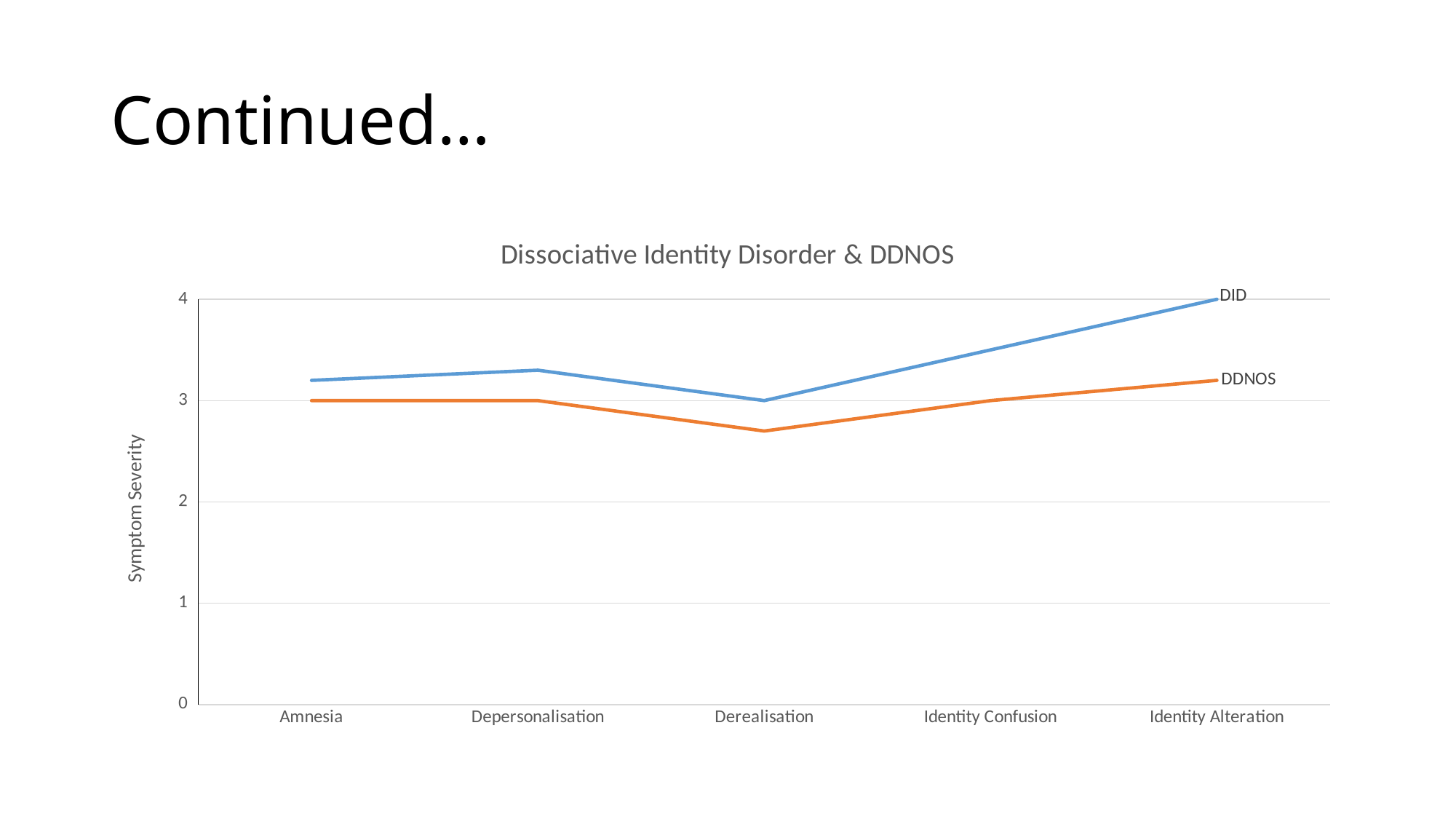
What is the title of the chart? Dissociative Identity Disorder & DDNOS How many symptom categories are shown along the x axis? 5 What is the DID value for Identity Alteration? 4 What kind of chart is shown on the slide? line chart For which category is the DID series highest? Identity Alteration What is the DDNOS value for Amnesia? 3 For which category is the DDNOS series lowest? Derealisation What is the label on the vertical axis of the chart? Symptom Severity Is the DDNOS value for Derealisation greater or less than 3? less Which series has the larger value for Identity Alteration, DID or DDNOS? DID How many series are plotted in the chart? 2 Does the DID series rise or fall from Derealisation to Identity Alteration? rise